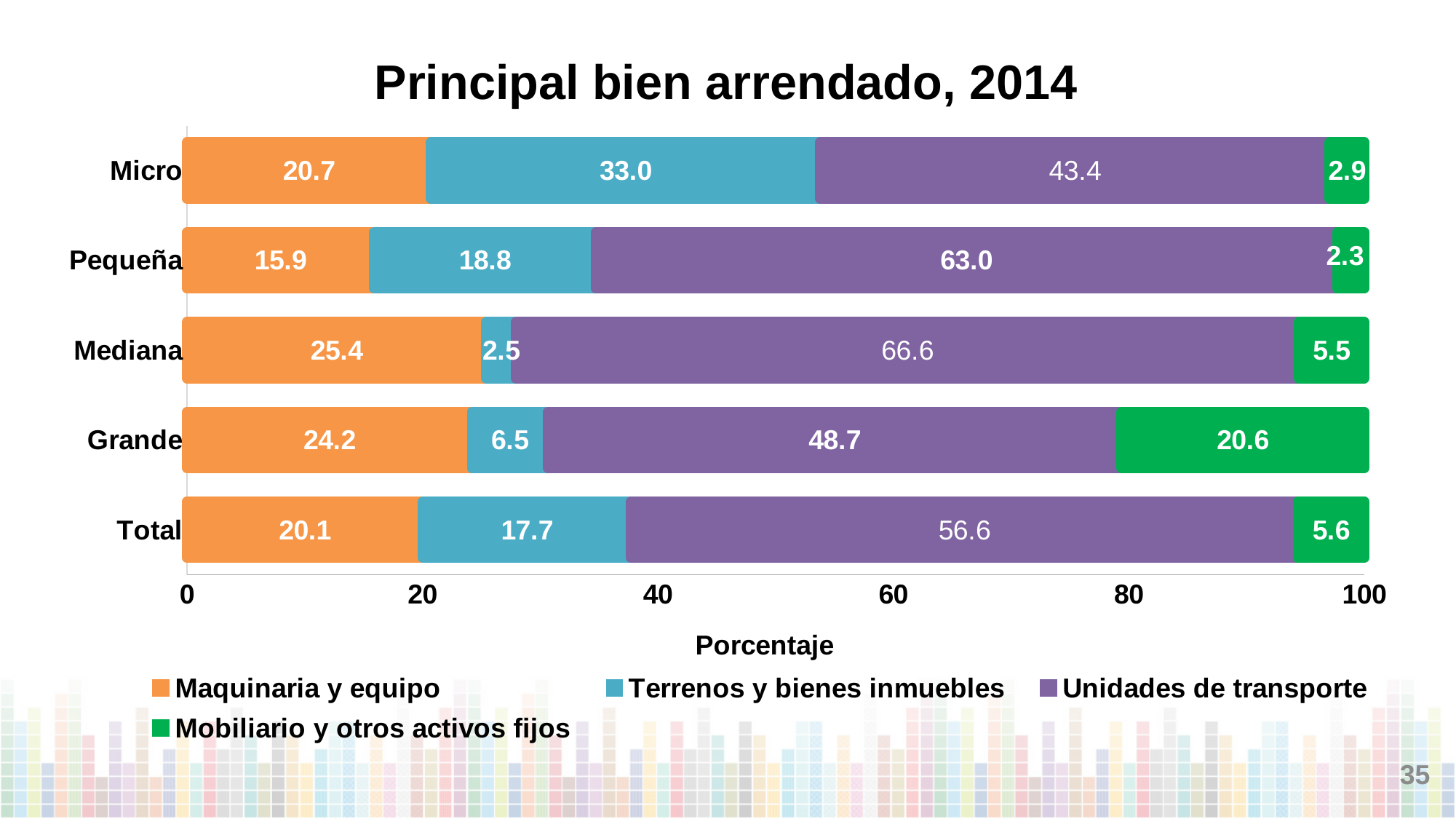
What is the value for Maquinaria y equipo in the Micro category? 20.7 What is the value for Mobiliario y otros activos fijos in the Grande category? 20.6 Which category has the lowest value for Terrenos y bienes inmuebles? Mediana What kind of chart is shown? Stacked bar chart How many series does the legend list? 4 What is the total of the stacked bar for Grande? 100.0 Which category has the highest value for Unidades de transporte? Mediana Which is larger: Terrenos y bienes inmuebles for Micro or for Pequeña? Micro What is the title of the chart? Principal bien arrendado, 2014 How many categories are shown on the y axis? 5 What is the value for Unidades de transporte in the Pequeña category? 63.0 What is the difference between Unidades de transporte and Maquinaria y equipo in the Micro category? 22.7